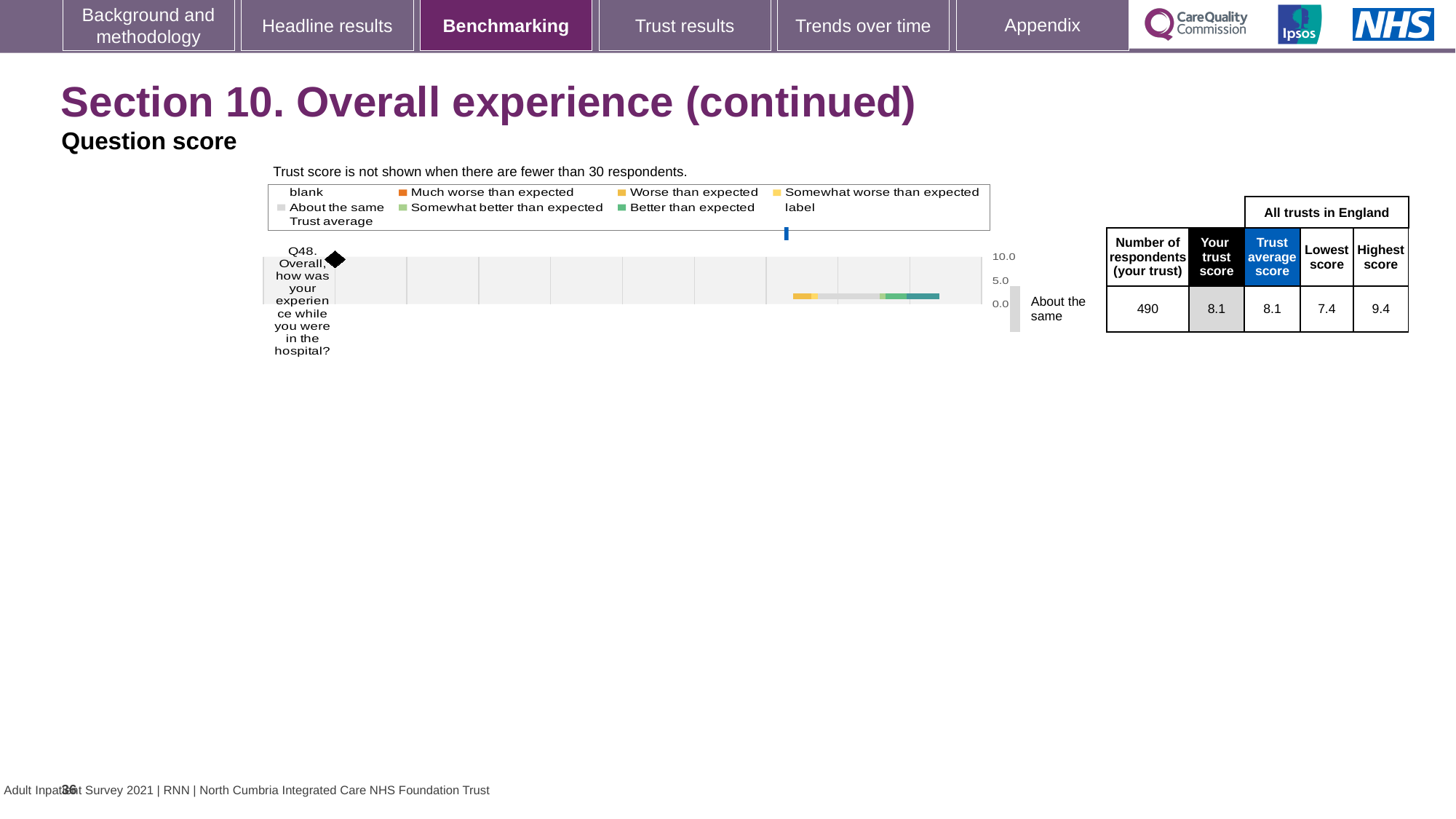
Is the trust's Q48 score greater or less than 5.0 on the chart's axis? greater What is the trust average score for Q48 across all trusts in England? 8.1 What kind of chart is used to show the Q48 benchmarking result? bar chart Is the trust's Q48 score higher than, lower than, or the same as the trust average score? the same What is the lowest score for Q48 among all trusts in England? 7.4 What is the trust's score for Q48? 8.1 What is the difference between the highest and lowest scores for Q48 among all trusts in England? 2.0 Which question is plotted on the chart? Q48. Overall, how was your experience while you were in the hospital? What is the highest score for Q48 among all trusts in England? 9.4 How many survey questions are plotted on the chart? 1 Which benchmark category does the trust's Q48 score fall into? About the same How many respondents from the trust answered Q48? 490